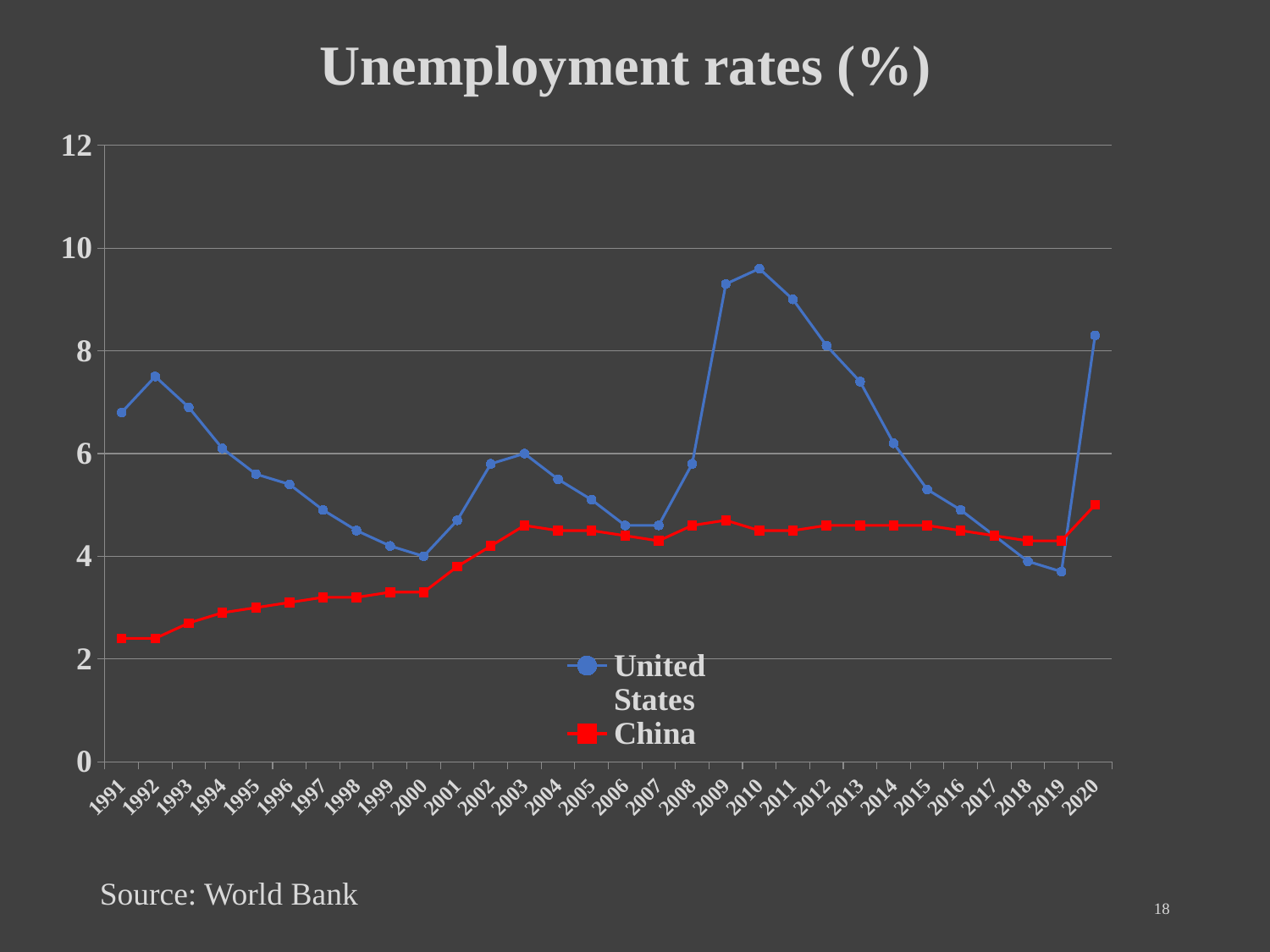
In which year is the China unemployment rate highest? 2020 Which series has the higher unemployment rate in 2010, United States or China? United States Is the unemployment rate for the United States in 2010 greater or less than 8? greater Is the unemployment rate for China in 2020 greater or less than 4? greater What is the source cited for the chart? World Bank How many series does the legend list? 2 Is the unemployment rate for the United States in 2020 greater or less than 6? greater What kind of chart is shown on the slide? line chart Does the China unemployment rate rise or fall from 1991 to 2003? rise In which year is the United States unemployment rate highest? 2010 How many years are plotted along the x axis? 30